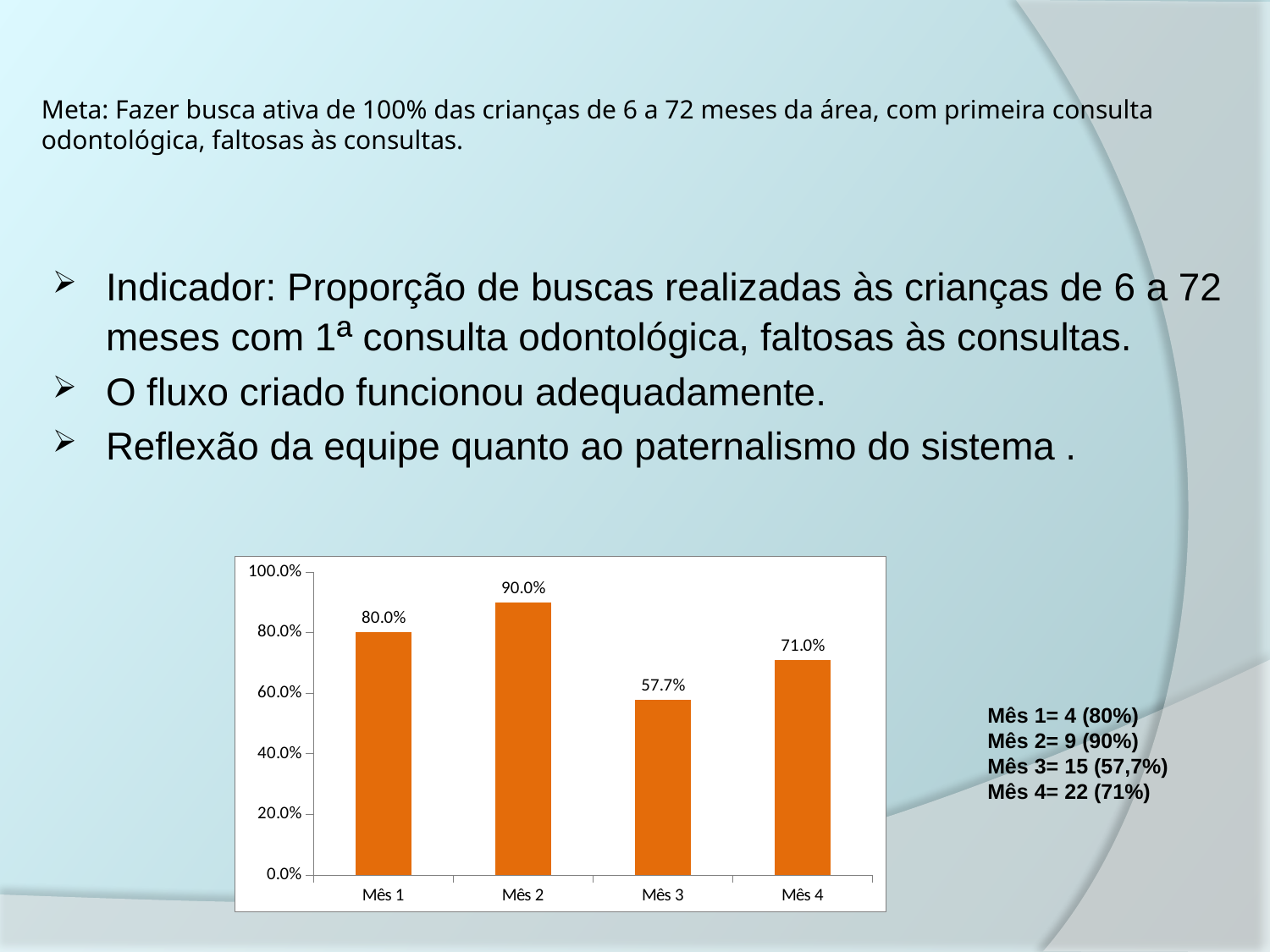
Which month has the lowest value? Mês 3 What is the difference between the values for Mês 2 and Mês 3? 32.3% Which month has the highest value? Mês 2 What kind of chart is shown on the slide? bar chart What is the value for Mês 3? 57.7% Which is larger, the value for Mês 1 or the value for Mês 4? Mês 1 What is the value for Mês 4? 71.0% What is the difference between the values for Mês 1 and Mês 4? 9.0% How many months are shown on the x axis? 4 Is the value for Mês 3 greater or less than 60.0%? less What is the value for Mês 2? 90.0% What is the value for Mês 1? 80.0%